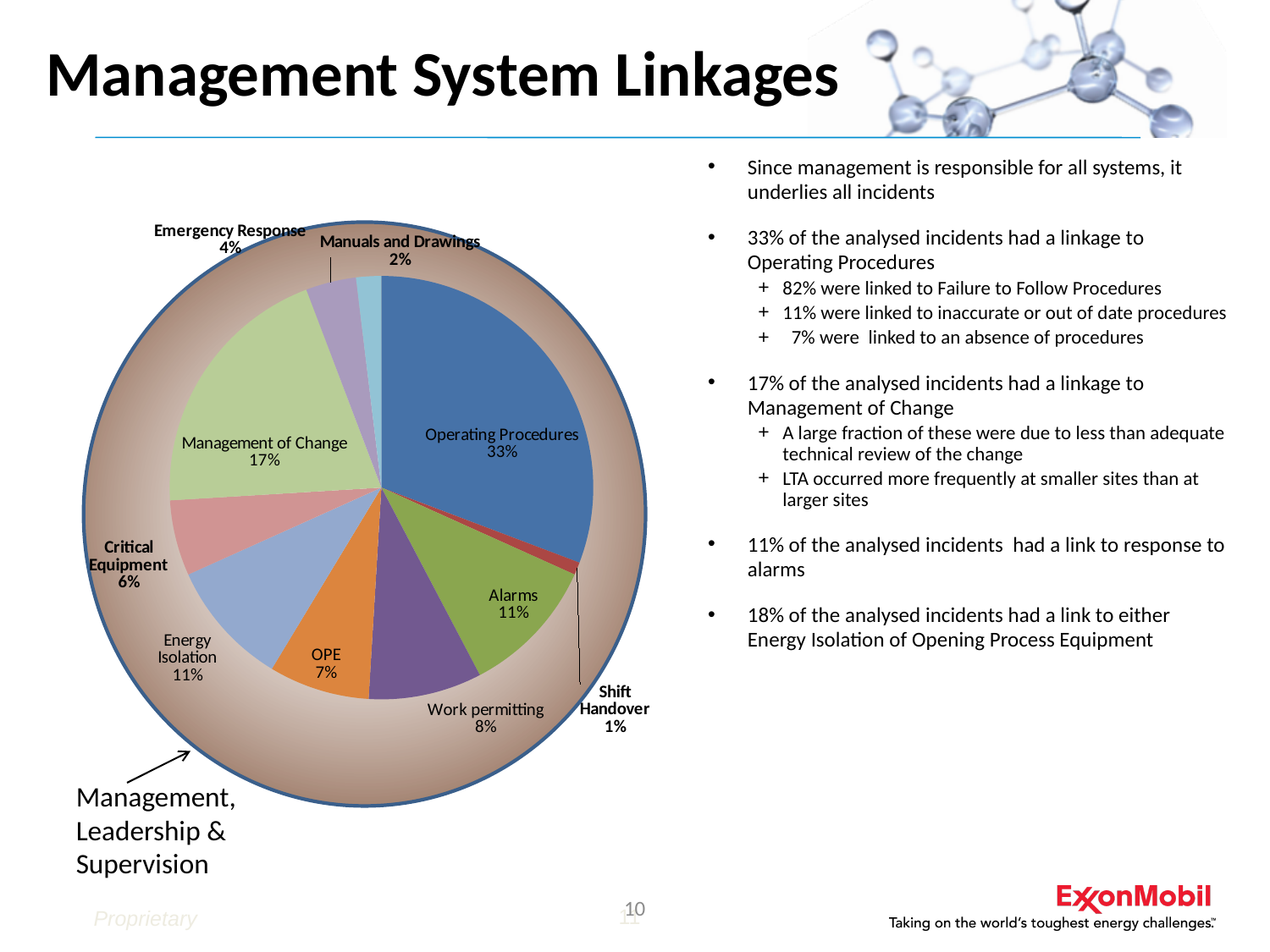
What is the value shown for Critical Equipment? 6% Which category has the smallest slice of the pie? Shift Handover Which is larger, the share for OPE or the share for Emergency Response? OPE What is the difference between the Operating Procedures share and the Management of Change share? 16% What is the value shown for Management of Change? 17% What is the value shown for Work permitting? 8% What label is attached to the outer ring surrounding the pie chart? Management, Leadership & Supervision Which category has the largest slice of the pie? Operating Procedures What share of the pie does Operating Procedures account for? 33% How many slices does the pie chart have? 10 What is the value shown for Manuals and Drawings? 2% What kind of chart is shown on the slide? Pie chart